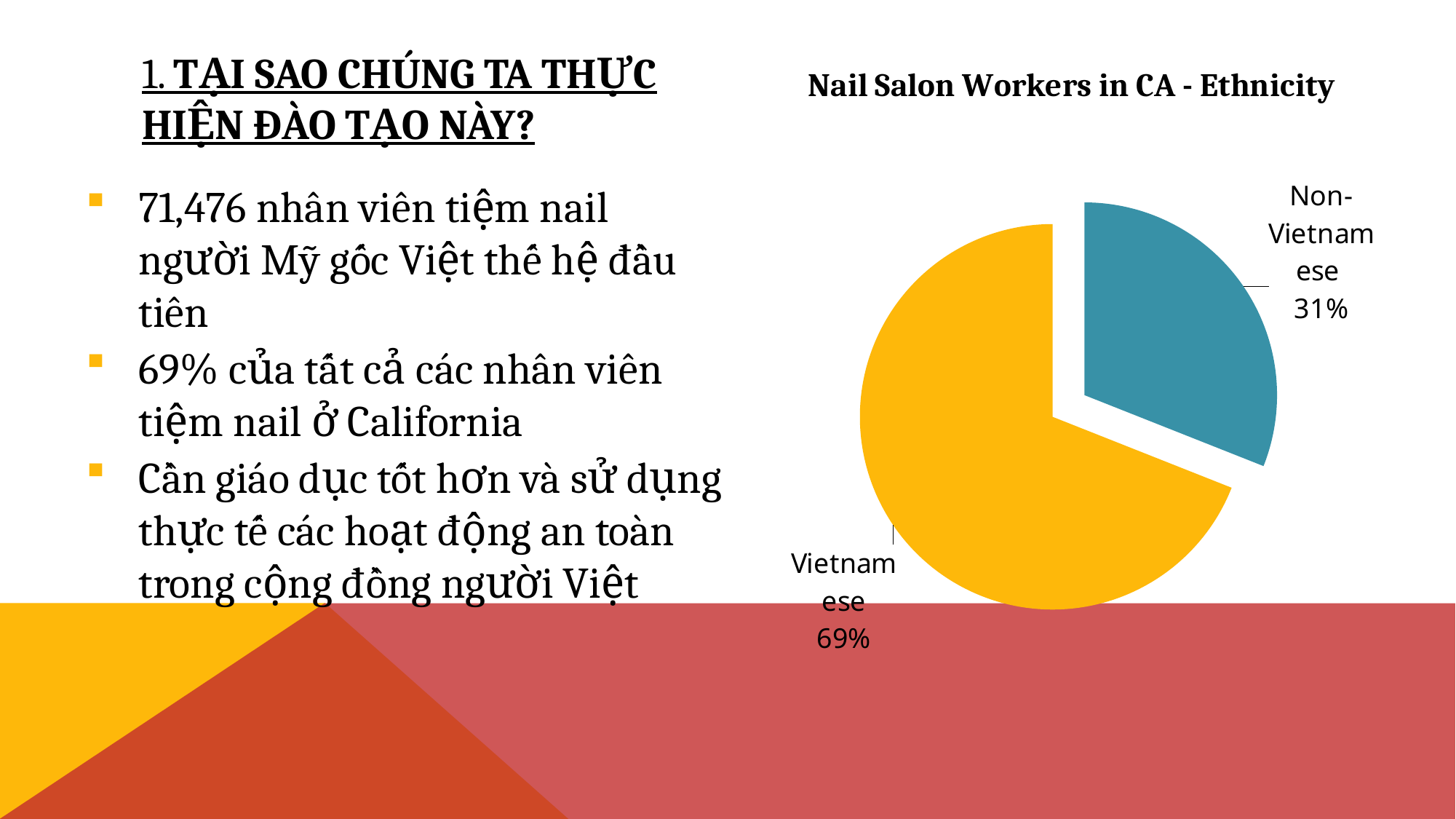
What share of nail salon workers in CA are Non-Vietnamese according to the chart? 31% Which slice of the pie is the largest? Vietnamese What is the difference in percentage points between the Vietnamese and Non-Vietnamese slices? 38 Which is larger, the Vietnamese slice or the Non-Vietnamese slice? Vietnamese What colour is the Vietnamese slice of the pie? yellow Is the Non-Vietnamese share greater or less than 50%? less What kind of chart is shown on the slide? pie chart How many slices does the pie chart have? 2 What share of nail salon workers in CA are Vietnamese according to the chart? 69% Which slice of the pie is the smallest? Non-Vietnamese What is the title of the chart? Nail Salon Workers in CA - Ethnicity